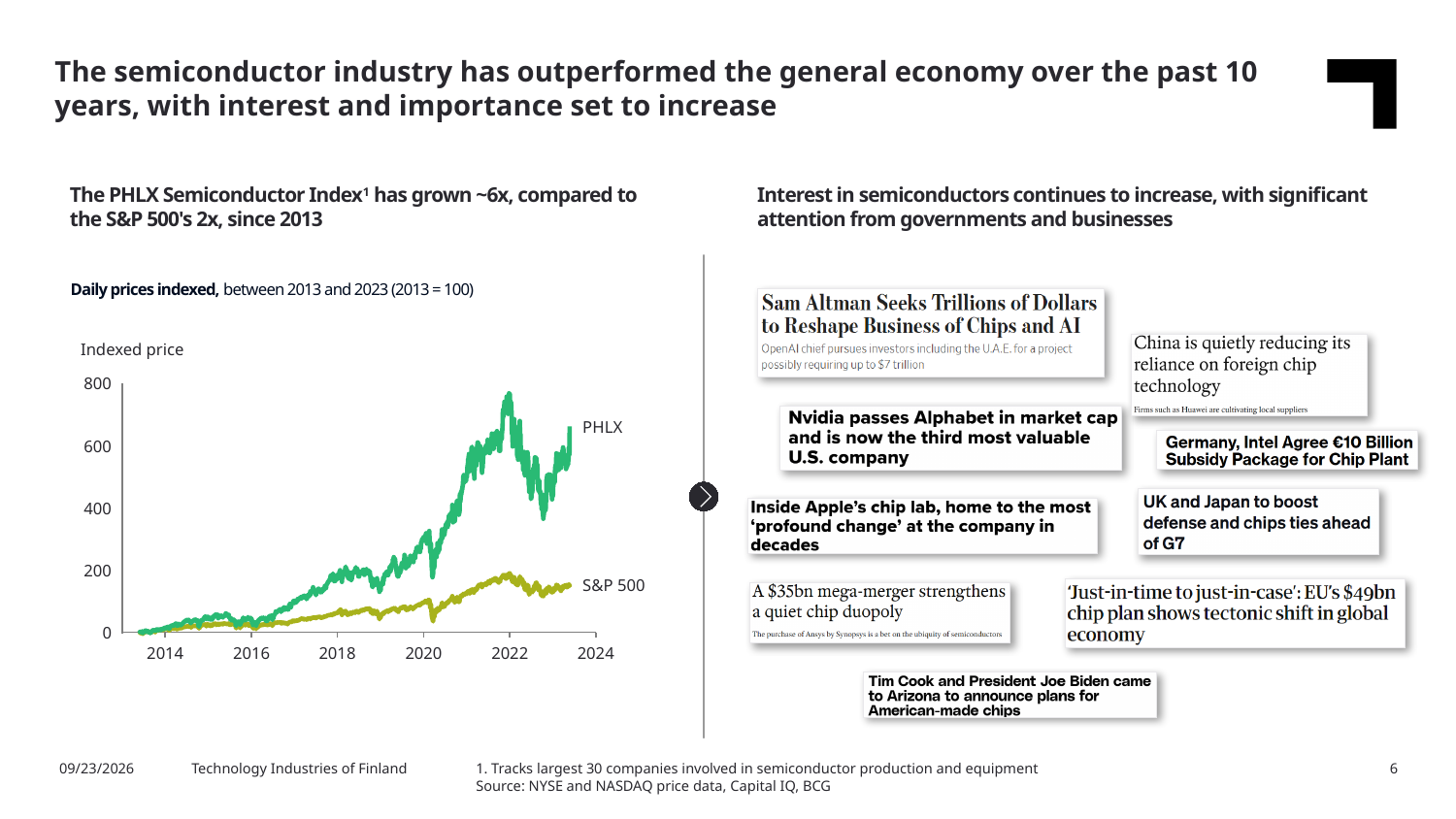
What kind of chart is shown on the slide? Line chart Is the value of the PHLX line in 2016 greater or less than 200? less How many series are plotted on the chart? 2 Which series reaches the higher value by the end of the period shown? PHLX Is the peak value of the PHLX line greater or less than 600? greater Does the S&P 500 line generally rise or fall over the period shown? rise Is the value of the S&P 500 line at the end of the period greater or less than 200? less Which series has the highest peak on the chart? PHLX What is the label of the y axis on the chart? Indexed price What is the highest value shown on the y axis of the chart? 800 Which two series are plotted on the chart? PHLX and S&P 500 Does the PHLX line generally rise or fall from 2014 to 2024? rise